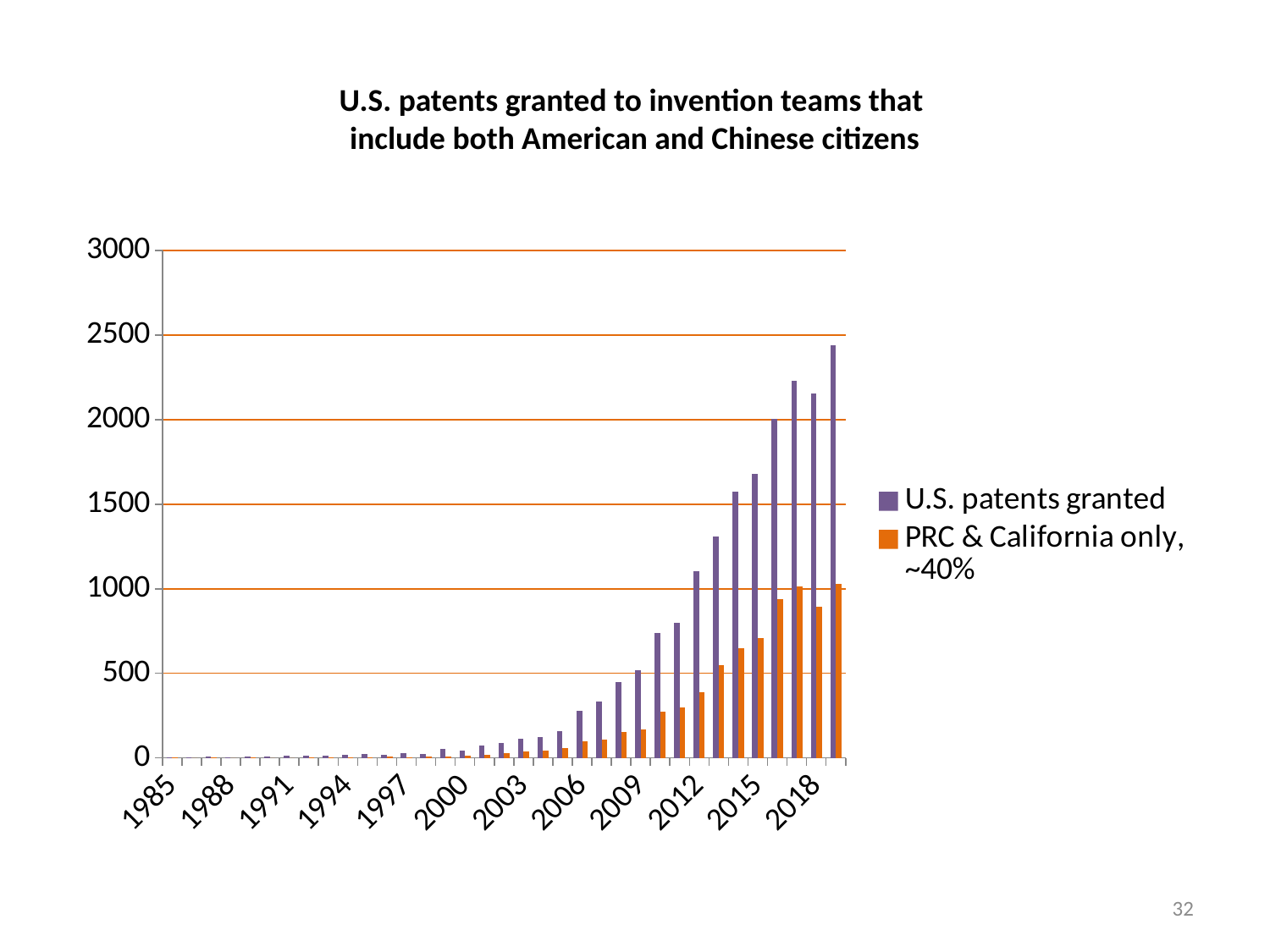
Do the values for 'U.S. patents granted' generally rise or fall from 1985 to 2018? Rise What kind of chart is shown on the slide? Bar chart Is the value for 'PRC & California only, ~40%' in 2012 greater or less than 500? less Is the value for 'U.S. patents granted' in 2012 greater or less than 1000? greater In which year is the value for 'U.S. patents granted' highest? 2019 What is the title of the chart? U.S. patents granted to invention teams that include both American and Chinese citizens Which is larger in 2018: 'U.S. patents granted' or 'PRC & California only, ~40%'? U.S. patents granted Is the value for 'U.S. patents granted' in 2018 greater or less than 2000? greater Which year has the larger value for 'U.S. patents granted': 2009 or 2012? 2012 How many series does the legend list? 2 Which colour represents the 'PRC & California only, ~40%' series? Orange